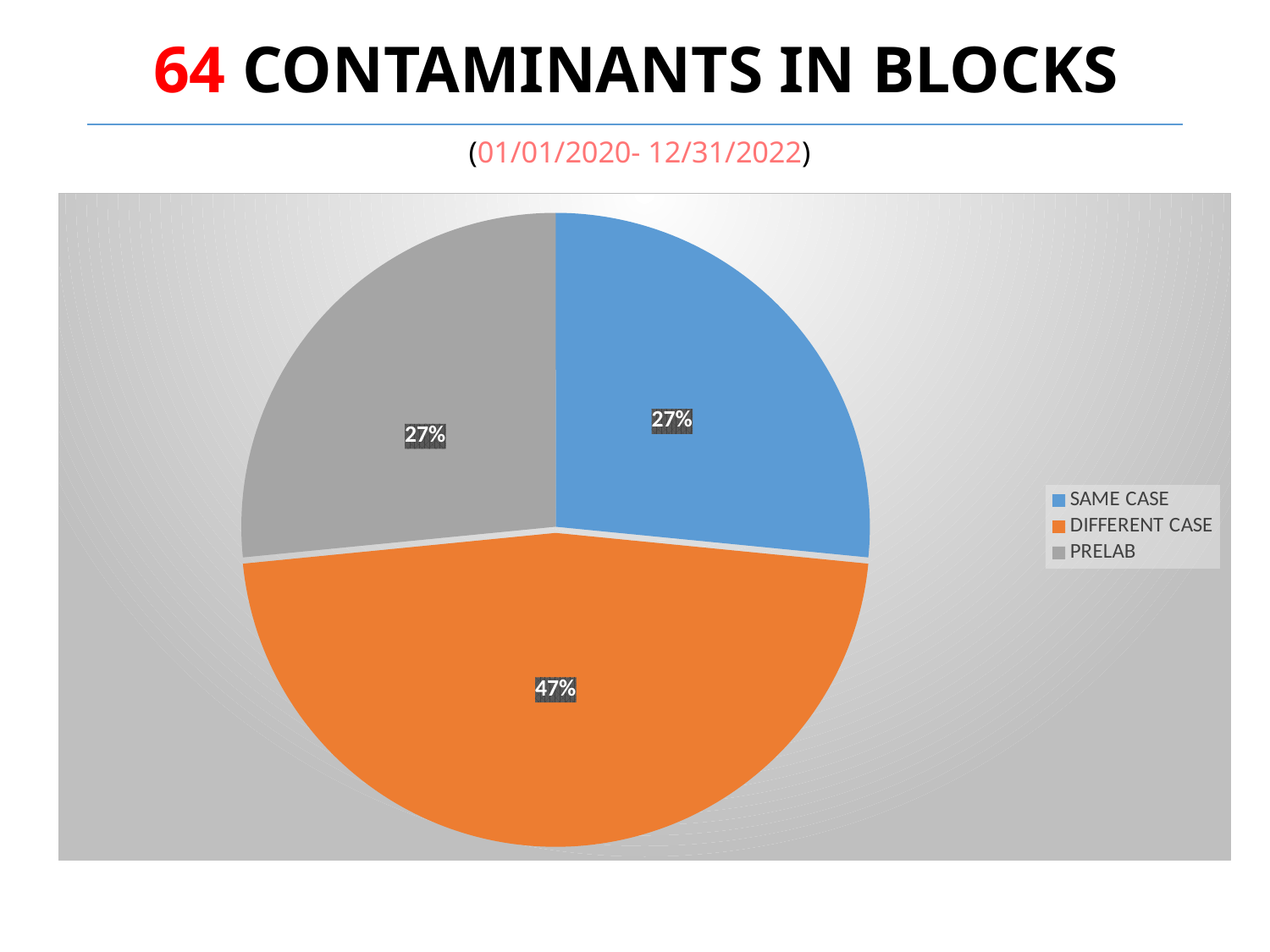
Which category has the largest share of the pie? DIFFERENT CASE What kind of chart is shown on the slide? Pie chart What share of the pie does DIFFERENT CASE represent? 47% What is the title of the slide? 64 CONTAMINANTS IN BLOCKS What is the difference in percentage points between the DIFFERENT CASE share and the SAME CASE share? 20 Which colour represents DIFFERENT CASE in the pie chart? Orange What share of the pie does PRELAB represent? 27% How many slices does the pie chart have? 3 How many entries does the legend list? 3 What share of the pie does SAME CASE represent? 27% Which is larger, the share for DIFFERENT CASE or the share for PRELAB? DIFFERENT CASE